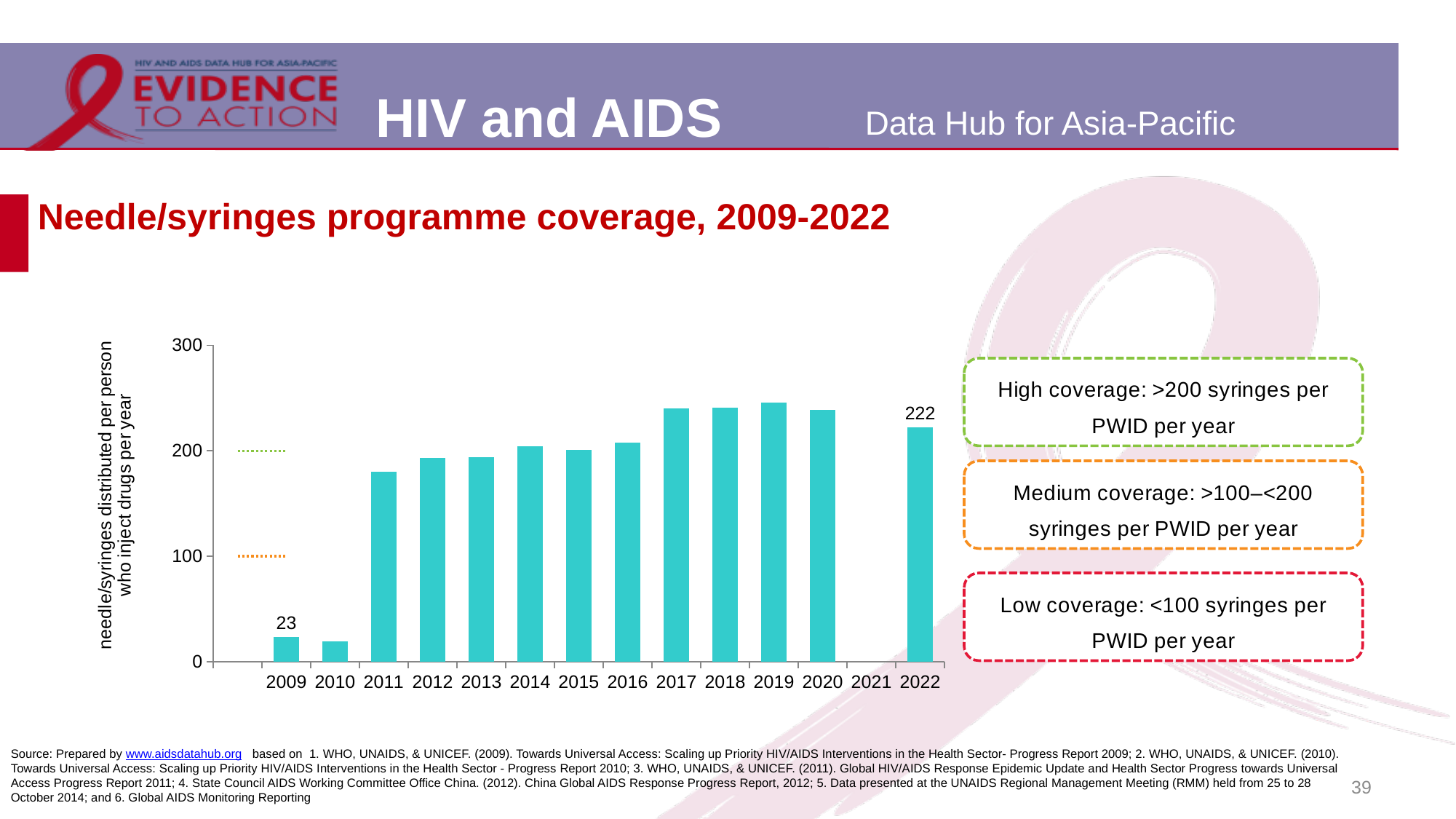
Is the value for 2017 greater or less than 200? greater Is the value for 2010 greater or less than 100? less What is the value for 2022? 222 Do the values generally rise or fall from 2009 to 2019? rise What is the title of the chart? Needle/syringes programme coverage, 2009-2022 Is the value for 2011 greater or less than 200? less What kind of chart is shown on the slide? bar chart Which year on the x axis has no bar plotted? 2021 Which is larger, the value for 2009 or the value for 2022? 2022 What is the difference between the values for 2022 and 2009? 199 Which is larger, the value for 2011 or the value for 2017? 2017 What is the value for 2009? 23